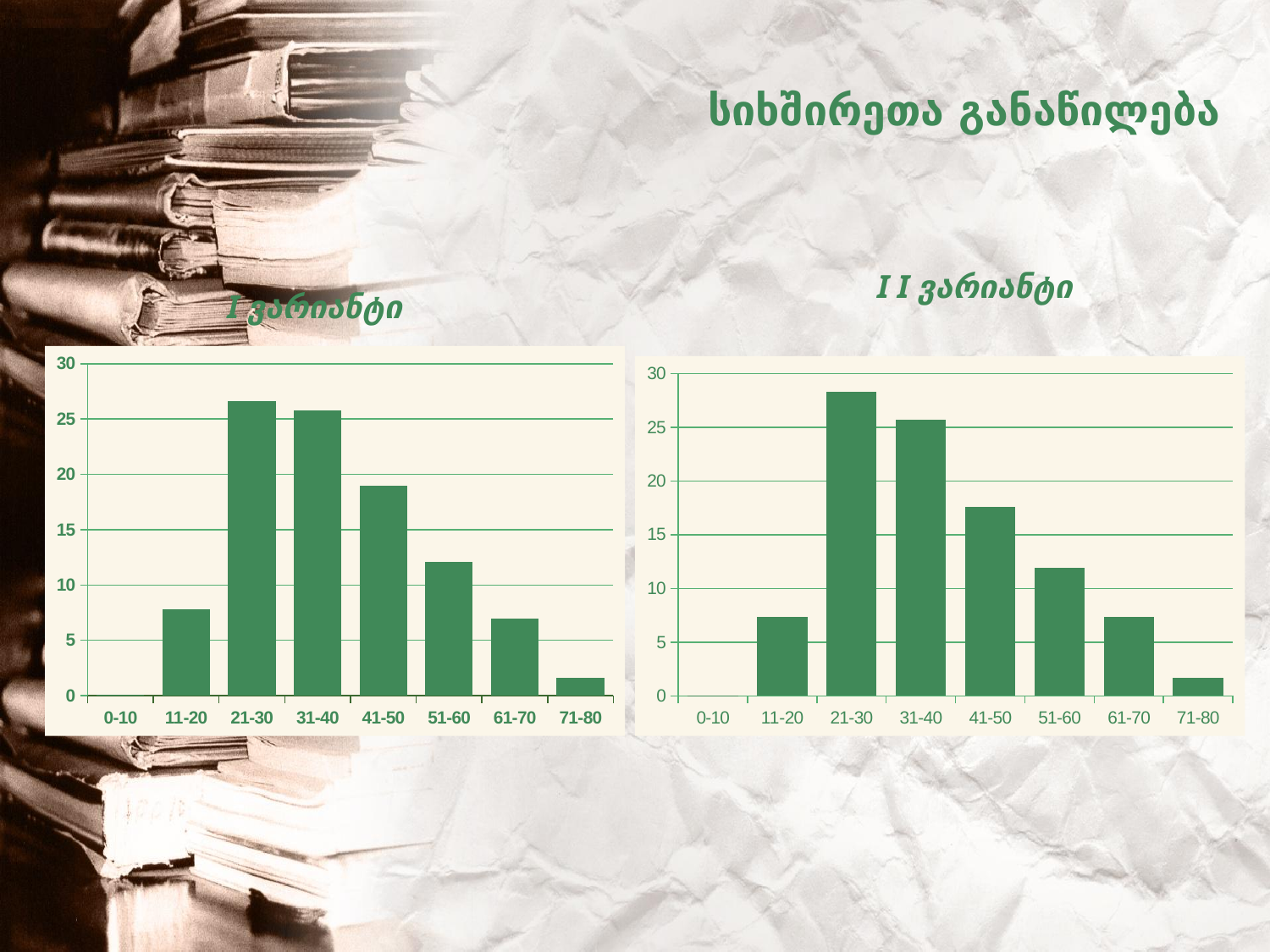
In the right chart titled "I I ვარიანტი", is the value for 21-30 greater or less than 25? greater In the left chart titled "I ვარიანტი", which is larger, the value for 41-50 or the value for 51-60? 41-50 In the left chart titled "I ვარიანტი", is the value for 11-20 greater or less than 10? less In the right chart titled "I I ვარიანტი", which is larger, the value for 21-30 or the value for 31-40? 21-30 What kind of chart is the left chart titled "I ვარიანტი"? bar chart In the left chart titled "I ვარიანტი", which category has the highest bar? 21-30 In the left chart titled "I ვარიანტი", do the values rise or fall from 21-30 to 71-80? fall In the right chart titled "I I ვარიანტი", is the value for 41-50 greater or less than 20? less How many categories are shown on the x axis of the right chart titled "I I ვარიანტი"? 8 What is the title of the chart on the right side of the slide? I I ვარიანტი In the right chart titled "I I ვარიანტი", which category has the highest bar? 21-30